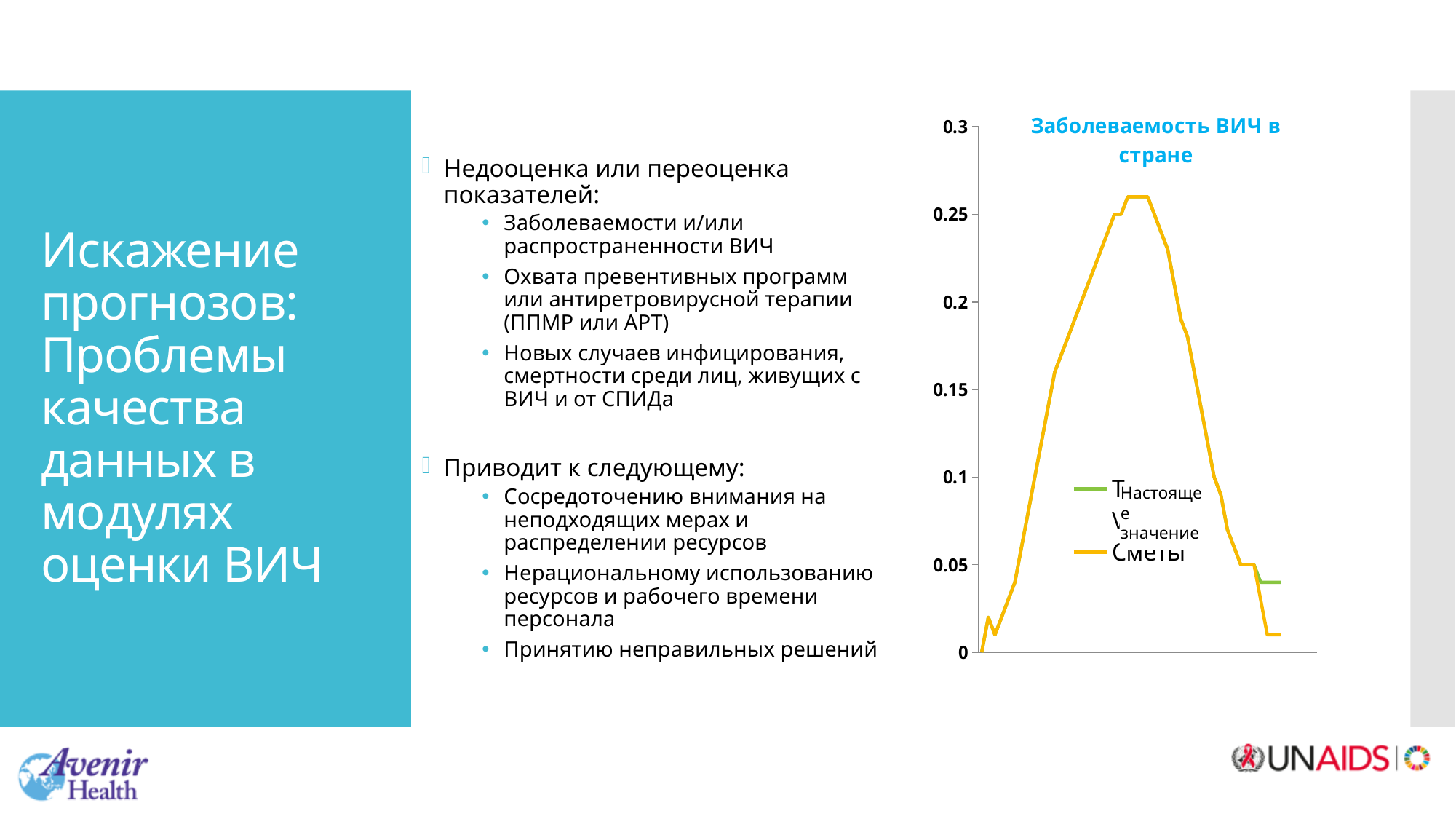
What kind of chart is shown on the slide? line chart What is the title of the chart? Заболеваемость ВИЧ в стране How many series does the chart legend list? 2 Is the Настоящее значение line greater or less than 0.1? less At the right end of the chart, which is higher: the Настоящее значение line or the final point of the Сметы line? Настоящее значение Does the Сметы line rise or fall over the right half of the chart? fall What is the highest value shown on the vertical axis? 0.3 Is the final value of the Сметы line greater or less than 0.05? less Which series is drawn in yellow according to the legend? Сметы Does the Сметы line rise or fall over the left half of the chart, up to its peak? rise Is the peak value of the Сметы line greater or less than 0.3? less